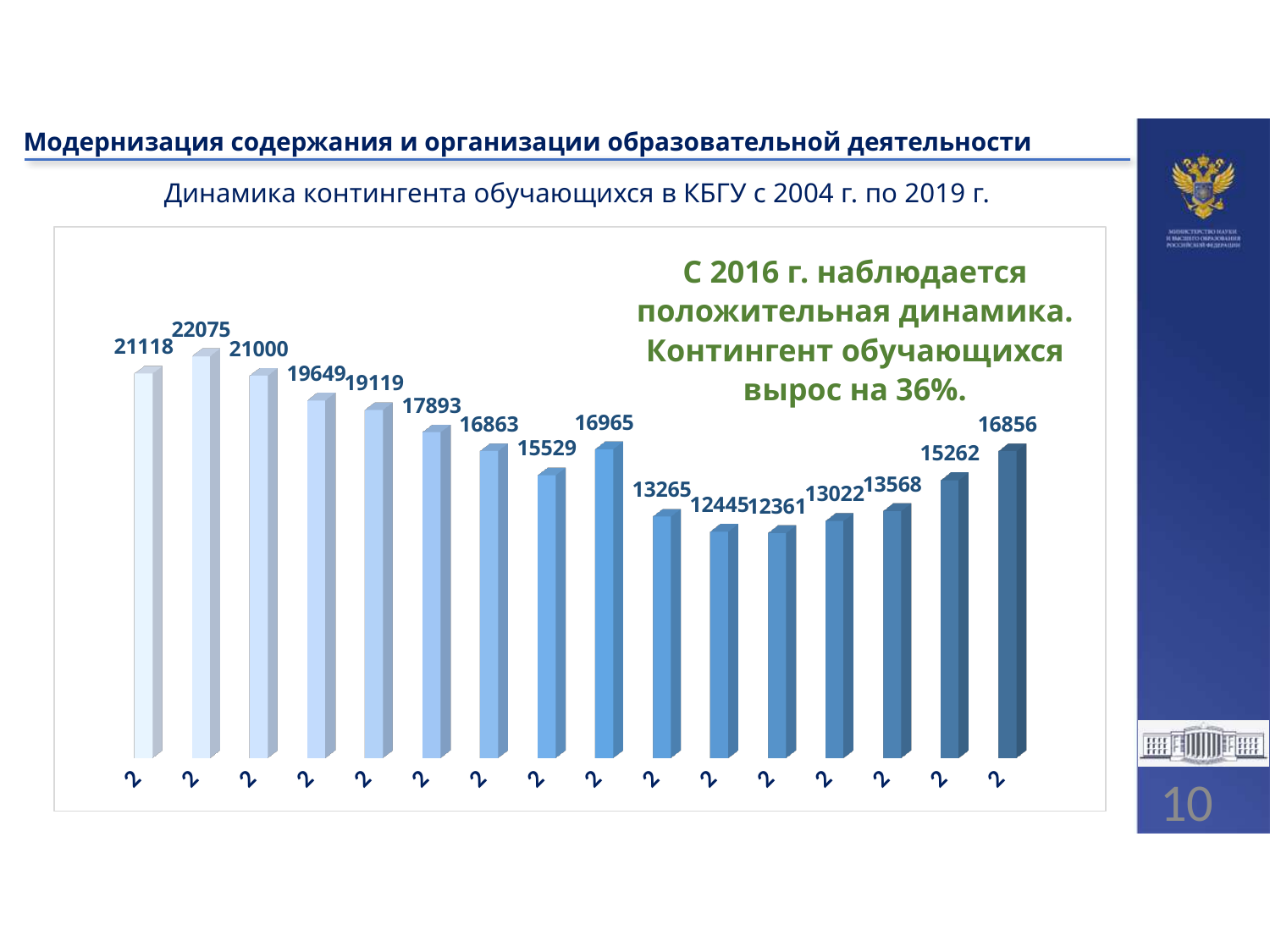
What is the difference between the highest value (22075) and the lowest value (12361) in the chart? 9714 What is the title of the chart? Динамика контингента обучающихся в КБГУ с 2004 г. по 2019 г. What is the highest value shown in the chart? 22075 What is the lowest value shown in the chart? 12361 Do the values rise or fall over the last five bars of the chart? rise What is the difference between the first bar (21118) and the second bar (22075)? 957 According to the text on the chart, by what percentage has the student contingent grown since 2016? 36% How many bars are plotted in the chart? 16 What kind of chart is shown on the slide? bar chart What is the value of the last (rightmost) bar in the chart? 16856 Which is larger, the value of the first bar or the value of the last bar? the first bar (21118) What is the value of the first (leftmost) bar in the chart? 21118